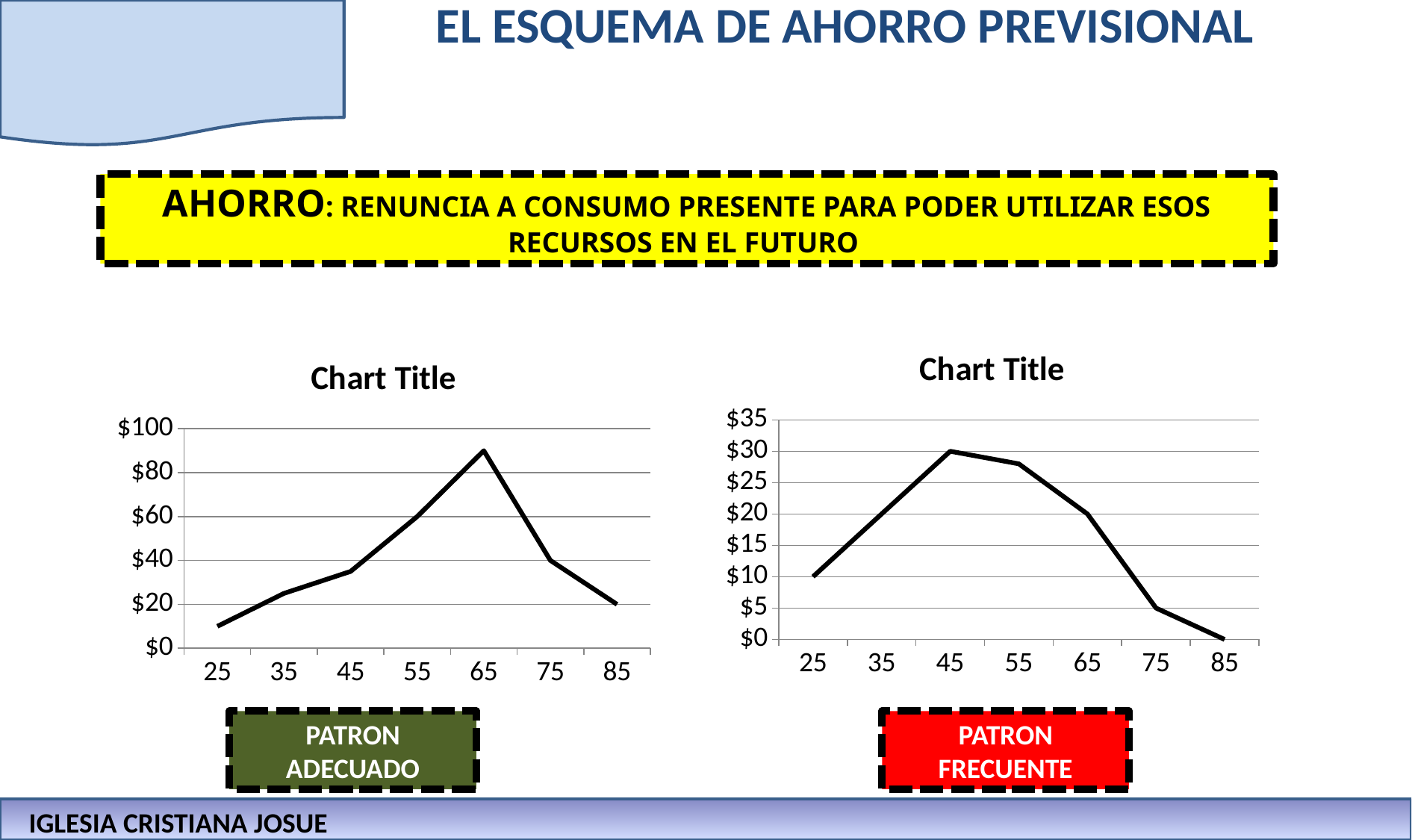
On the right chart (above PATRON FRECUENTE), do the values rise or fall from 55 to 85? fall On the left chart (above PATRON ADECUADO), is the value at 65 greater or less than $80? greater On the left chart (above PATRON ADECUADO), at which x-axis category is the value highest? 65 How many points are plotted on the left chart (above PATRON ADECUADO)? 7 On the right chart (above PATRON FRECUENTE), at which x-axis category is the value highest? 45 On the left chart (above PATRON ADECUADO), which is larger, the value at 55 or the value at 85? 55 On the right chart (above PATRON FRECUENTE), what is the value at 85? $0 What kind of chart is the right chart (above PATRON FRECUENTE)? line chart On the left chart (above PATRON ADECUADO), what is the value at 75? $40 What kind of chart is the left chart (above PATRON ADECUADO)? line chart On the right chart (above PATRON FRECUENTE), what is the value at 45? $30 On the right chart (above PATRON FRECUENTE), at which x-axis category is the value lowest? 85